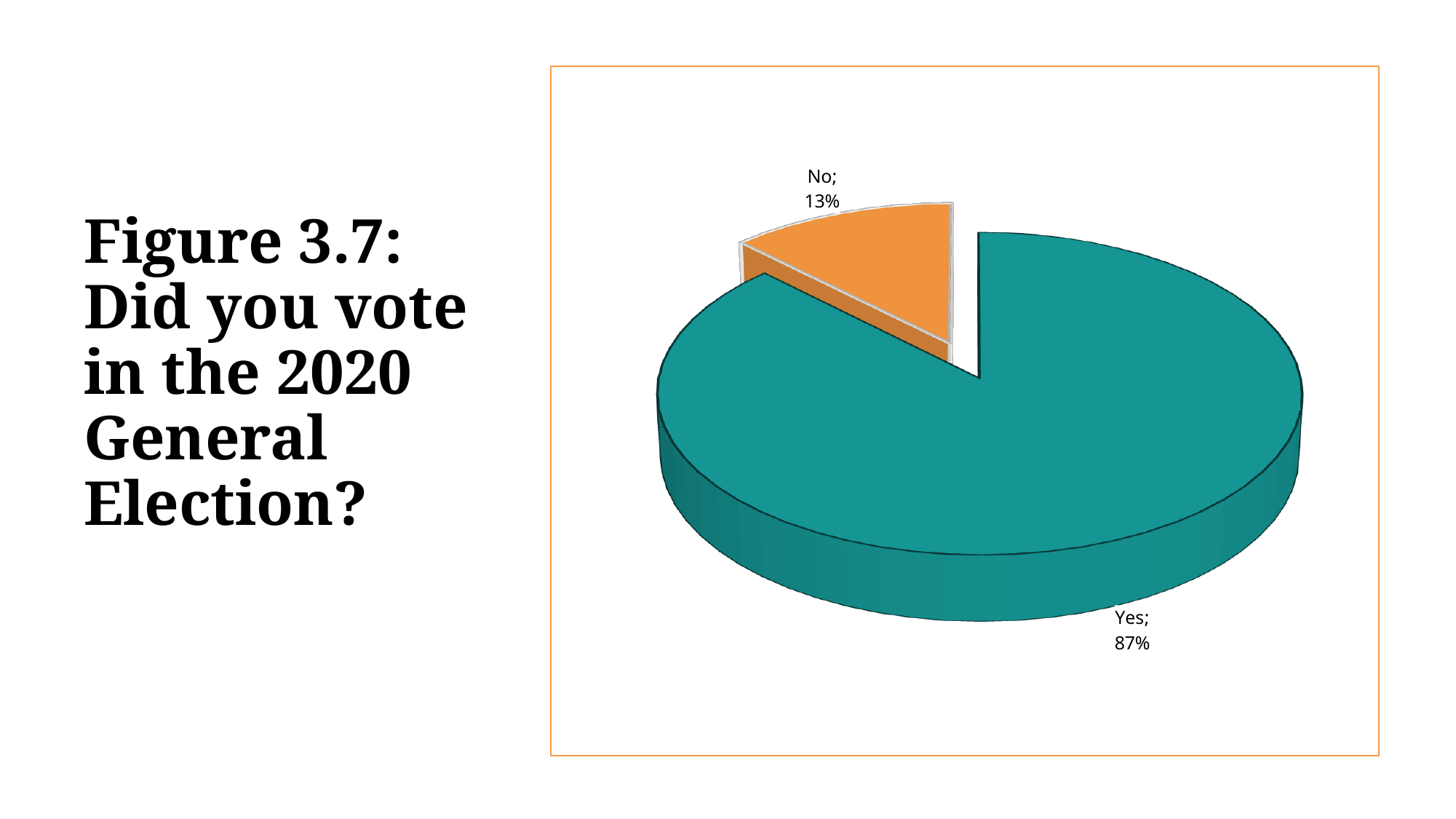
What is the figure number given in the slide title? Figure 3.7 What percentage of respondents answered "No"? 13% Which response has the largest share of the pie? Yes What share of the pie does the "No" slice represent? 13% What percentage of respondents answered "Yes" to voting in the 2020 General Election? 87% What kind of chart is shown on the slide? Pie chart Which response has the smallest share of the pie? No How many slices does the pie chart have? 2 What is the difference in percentage points between the "Yes" and "No" slices? 74 Which slice is larger, "Yes" or "No"? Yes What colour is the "No" slice? Orange